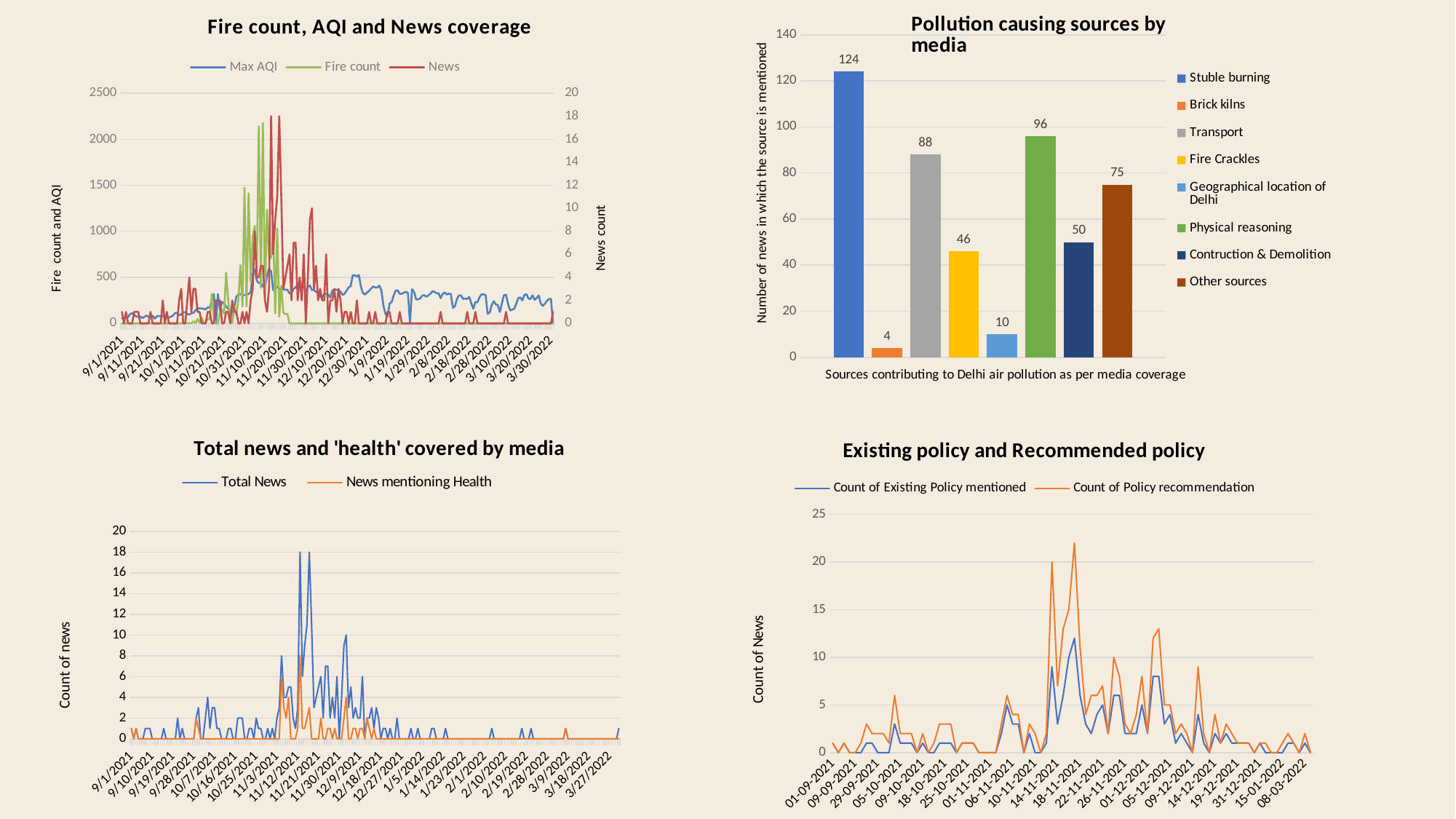
What kind of chart is 'Total news and 'health' covered by media'? Line chart In the 'Pollution causing sources by media' chart, what is the difference between Physical reasoning and Other sources? 21 In the 'Existing policy and Recommended policy' chart, is the peak value of Count of Policy recommendation greater or less than 20? greater In the 'Pollution causing sources by media' chart, which source has the lowest value? Brick kilns What kind of chart is 'Pollution causing sources by media'? Bar chart In the 'Pollution causing sources by media' chart, which source has the highest value? Stuble burning In the 'Pollution causing sources by media' chart, how many sources are plotted? 8 In the 'Pollution causing sources by media' chart, what is the value for Transport? 88 In the 'Pollution causing sources by media' chart, which is larger: Fire Crackles or Contruction & Demolition? Contruction & Demolition How many series does the legend of the 'Fire count, AQI and News coverage' chart list? 3 In the 'Pollution causing sources by media' chart, what is the value for Stuble burning? 124 In the 'Pollution causing sources by media' chart, what is the value for Geographical location of Delhi? 10